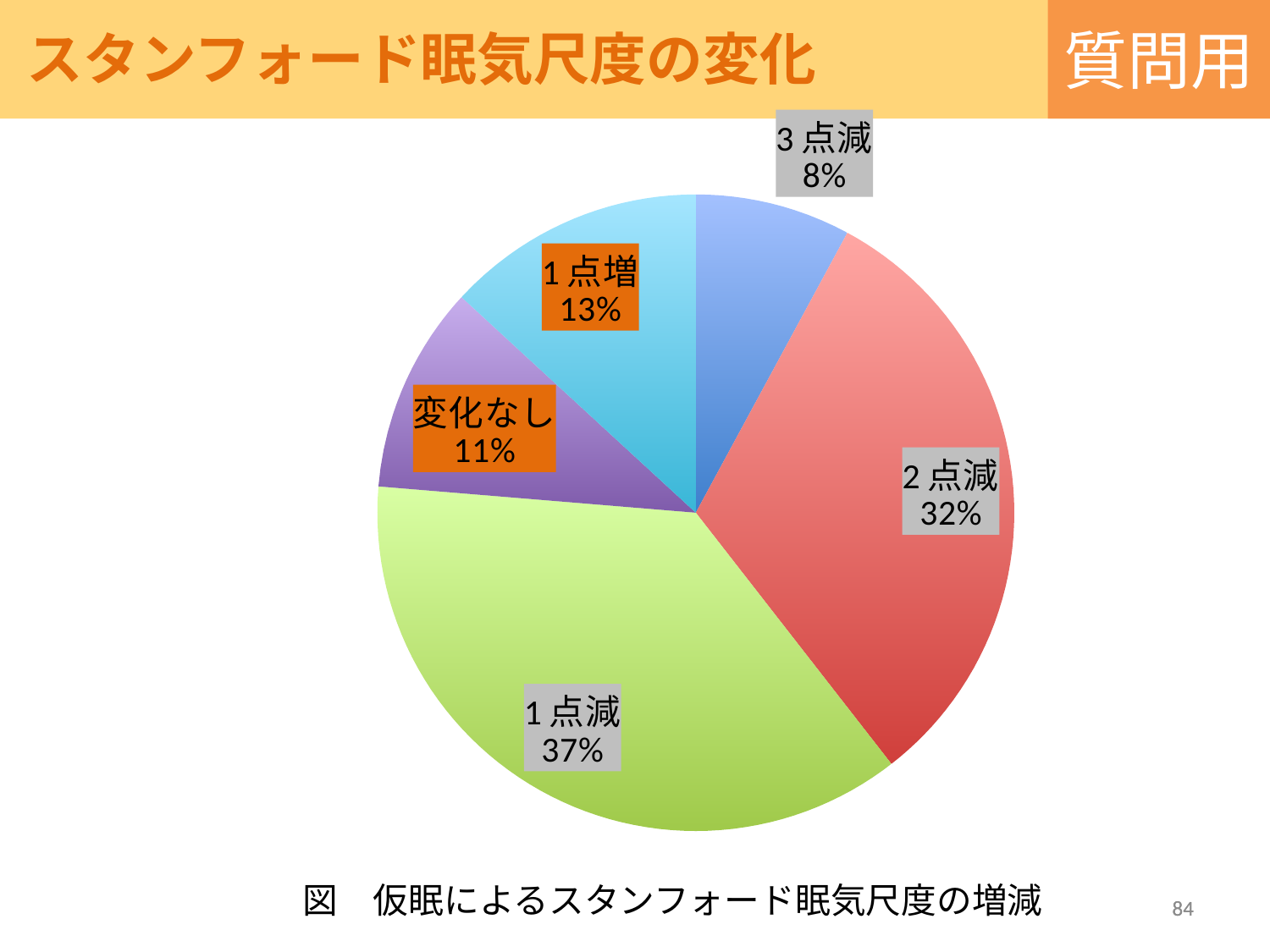
What is the caption shown below the pie chart? 図 仮眠によるスタンフォード眠気尺度の増減 Which category has the smallest slice of the pie? 3点減 Which category has the largest slice of the pie? 1点減 What is the difference in percentage points between 1点減 and 2点減? 5 What share of the pie does 1点減 represent? 37% What share of the pie does 2点減 represent? 32% How many slices does the pie chart have? 5 What is the value shown for 変化なし? 11% What is the value shown for 3点減? 8% What kind of chart is shown on the slide? pie chart What is the value shown for 1点増? 13% Which is larger, the share for 1点増 or the share for 変化なし? 1点増